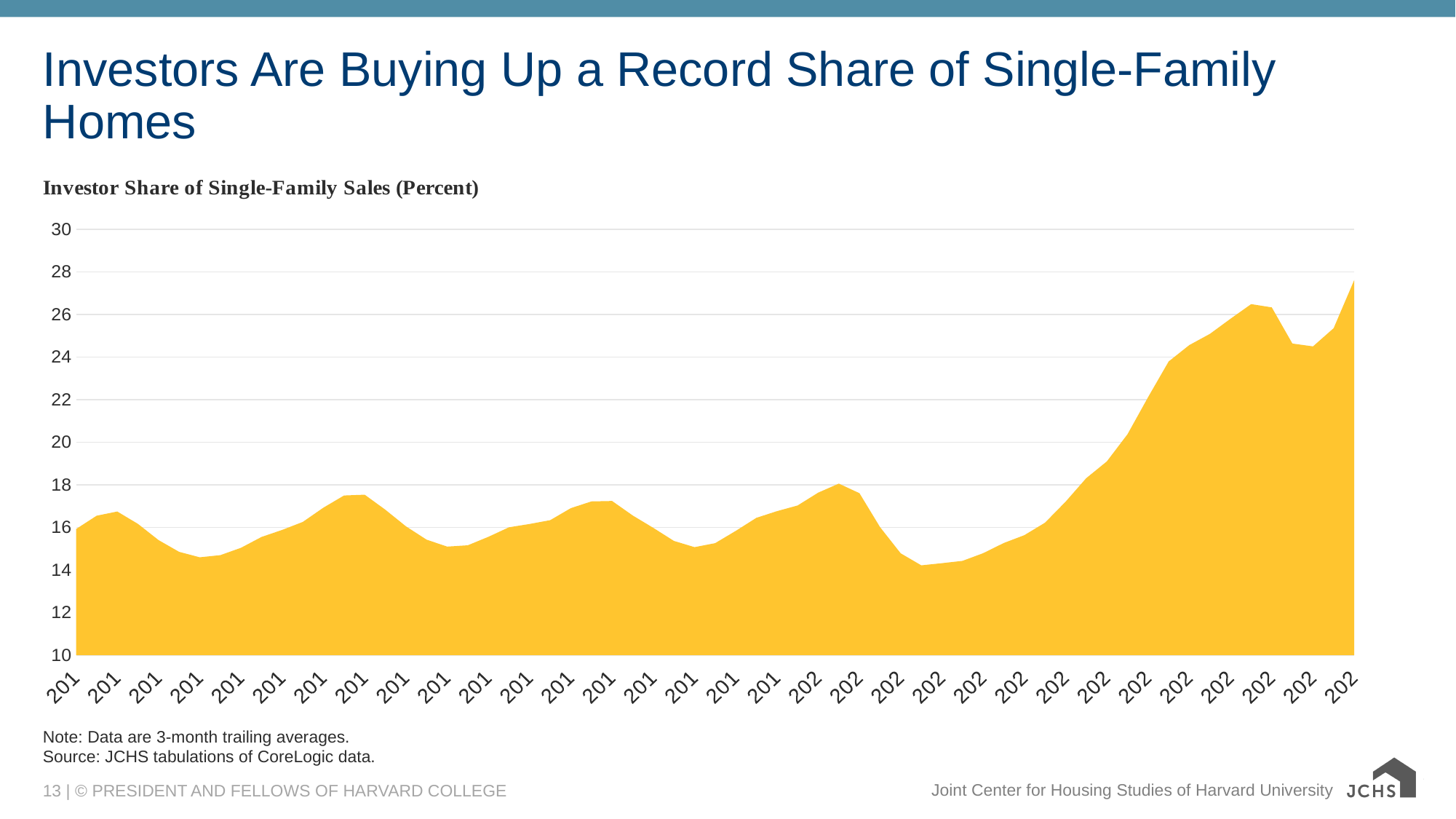
Overall, does the investor share of single-family sales rise or fall from the left of the chart to the right? Rise What is the highest value shown on the y axis? 30 Is the value at the right-hand end of the series greater or less than 26? greater What is the subtitle printed above the chart? Investor Share of Single-Family Sales (Percent) Which is larger, the value at the start of the series or the value at the end of the series? The value at the end Is the value at the left-hand start of the series greater or less than 14? greater Is the highest point of the series greater or less than 24? greater Where along the x axis does the series reach its highest value? At the right-hand end (most recent period) What kind of chart is shown on the slide? Area chart